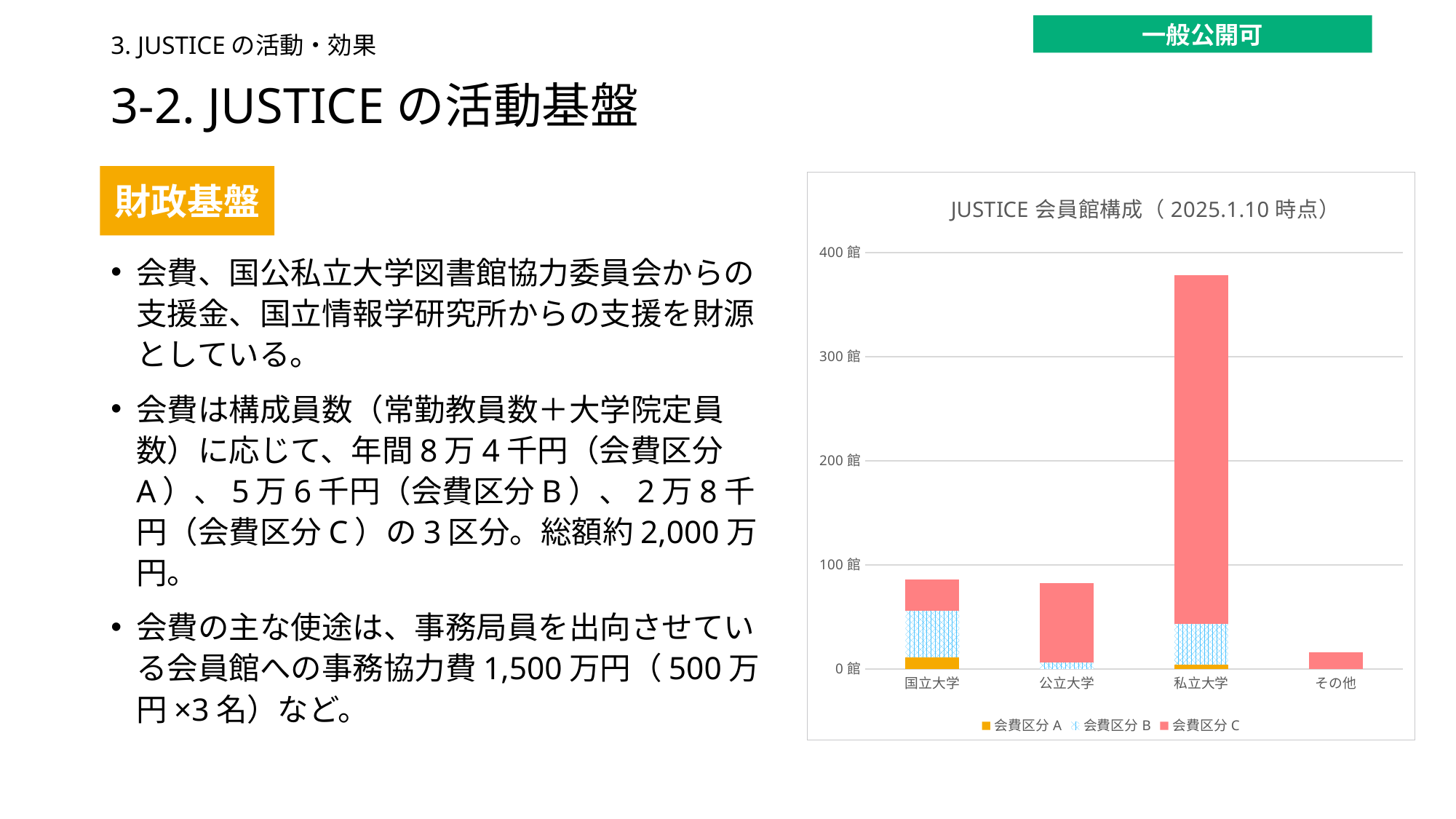
Which series is shown in red in the chart's legend? 会費区分 C Is the total value for 私立大学 greater or less than 300 館? greater Which has the larger total, 国立大学 or その他? 国立大学 Which category has the shortest stacked bar? その他 Which category has the tallest stacked bar? 私立大学 Is the total value for その他 greater or less than 100 館? less Is the total value for 国立大学 greater or less than 100 館? less What kind of chart is shown on the slide? Stacked bar chart How many series does the chart's legend list? 3 What is the title of the chart? JUSTICE 会員館構成（2025.1.10 時点） How many categories are shown on the x axis of the chart? 4 Which has the larger total, 私立大学 or 公立大学? 私立大学